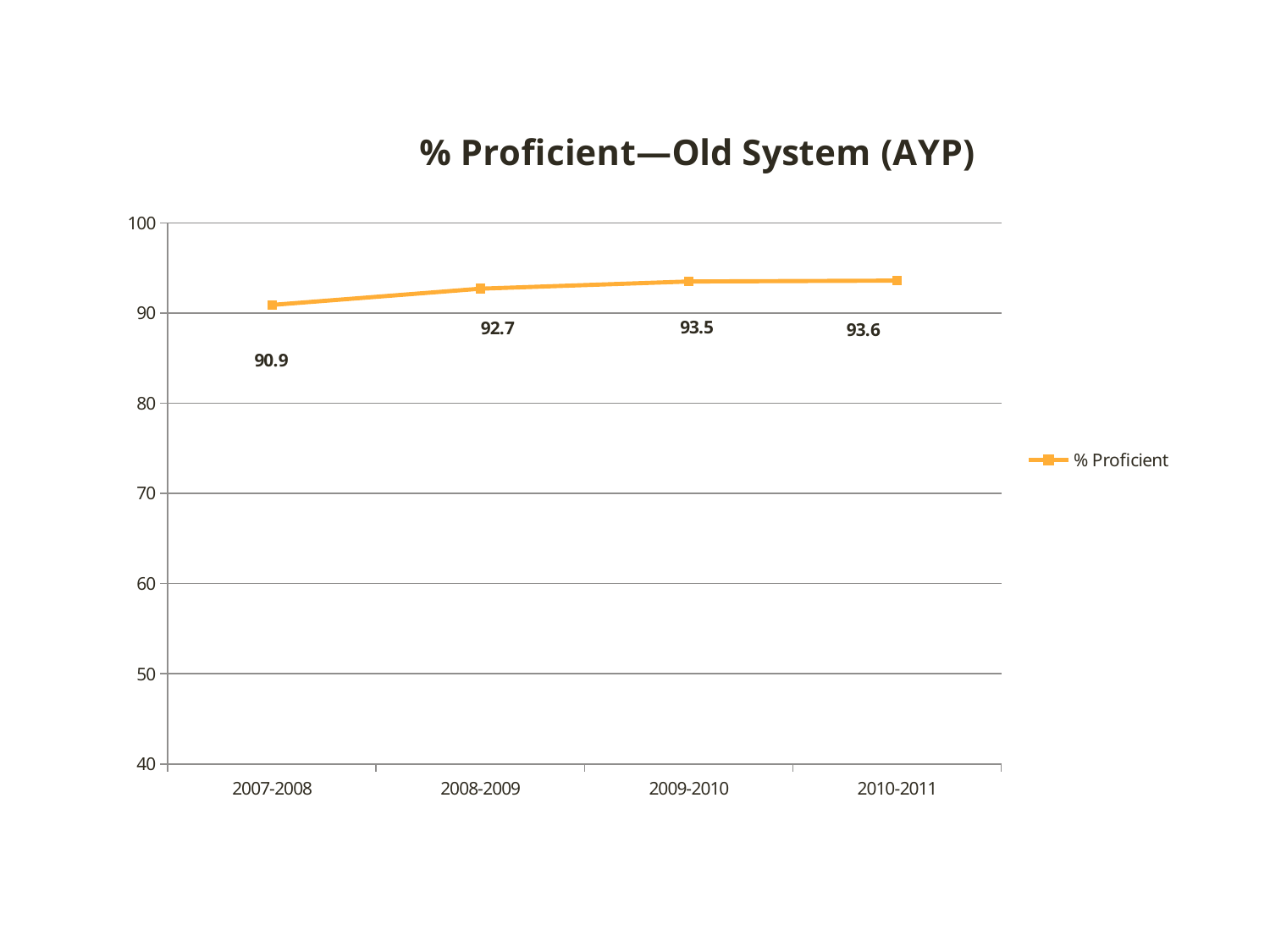
Which is larger, the % Proficient value for 2009-2010 or for 2007-2008? 2009-2010 What is the difference between the % Proficient values for 2008-2009 and 2007-2008? 1.8 What kind of chart is shown on the slide? line chart How many school years are plotted on the chart? 4 What is the % Proficient value for 2007-2008? 90.9 What is the % Proficient value for 2009-2010? 93.5 What is the % Proficient value for 2008-2009? 92.7 What is the % Proficient value for 2010-2011? 93.6 Which school year has the lowest % Proficient value? 2007-2008 Is the value for 2007-2008 greater or less than 90? greater What is the difference between the % Proficient values for 2010-2011 and 2007-2008? 2.7 Do the % Proficient values rise or fall from 2007-2008 to 2010-2011? rise